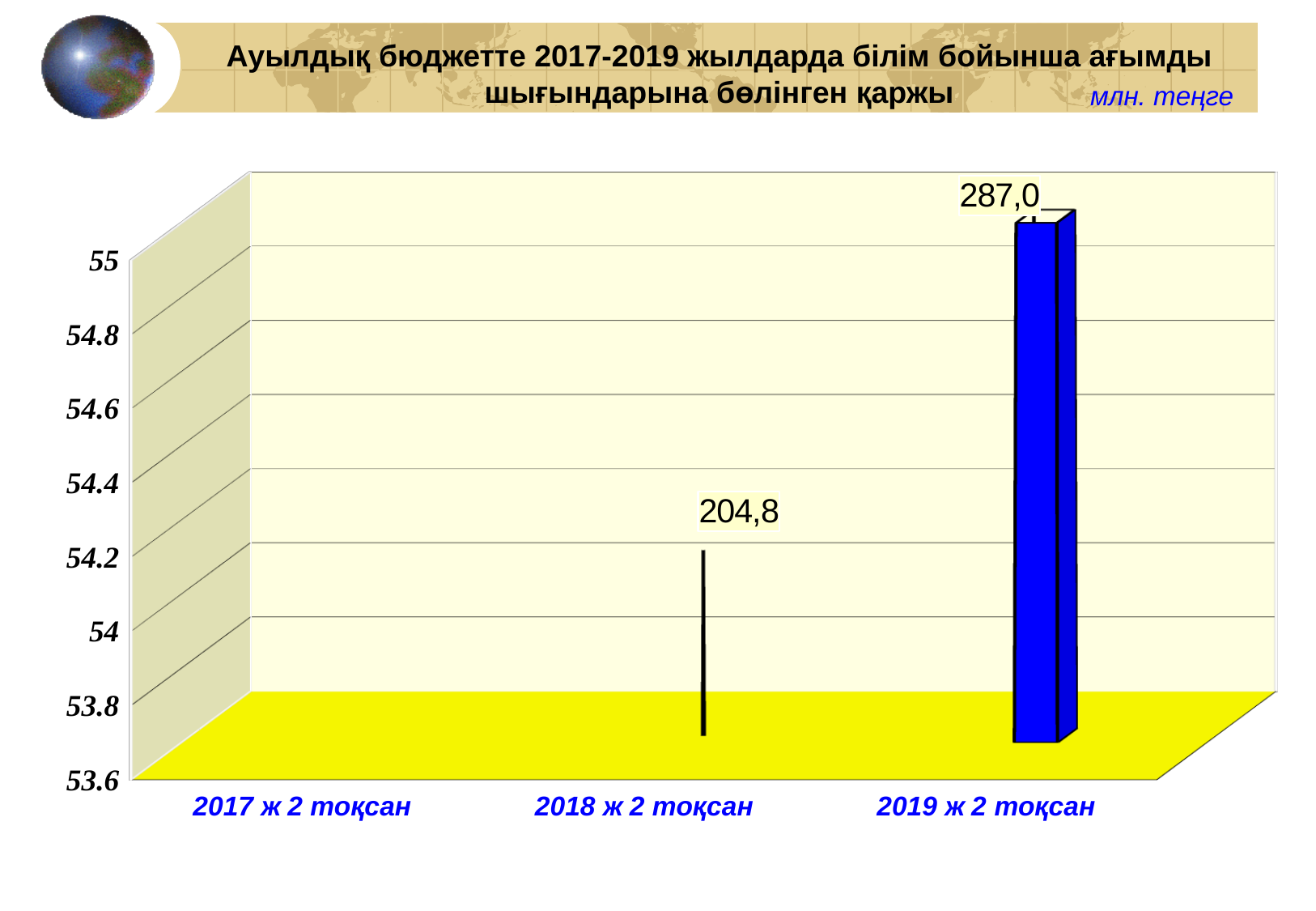
What unit is indicated in the top right of the slide? млн. теңге What is the difference between the values for 2019 ж 2 тоқсан and 2018 ж 2 тоқсан? 82,2 Which is larger, the value for 2018 ж 2 тоқсан or 2019 ж 2 тоқсан? 2019 ж 2 тоқсан What value is shown for 2018 ж 2 тоқсан? 204,8 How many categories are shown on the x axis? 3 Does the value rise or fall from 2018 ж 2 тоқсан to 2019 ж 2 тоқсан? Rise What kind of chart is this? Bar chart What colour is the bar for 2019 ж 2 тоқсан? Blue Which category has the highest labelled value? 2019 ж 2 тоқсан What value is shown for 2019 ж 2 тоқсан? 287,0